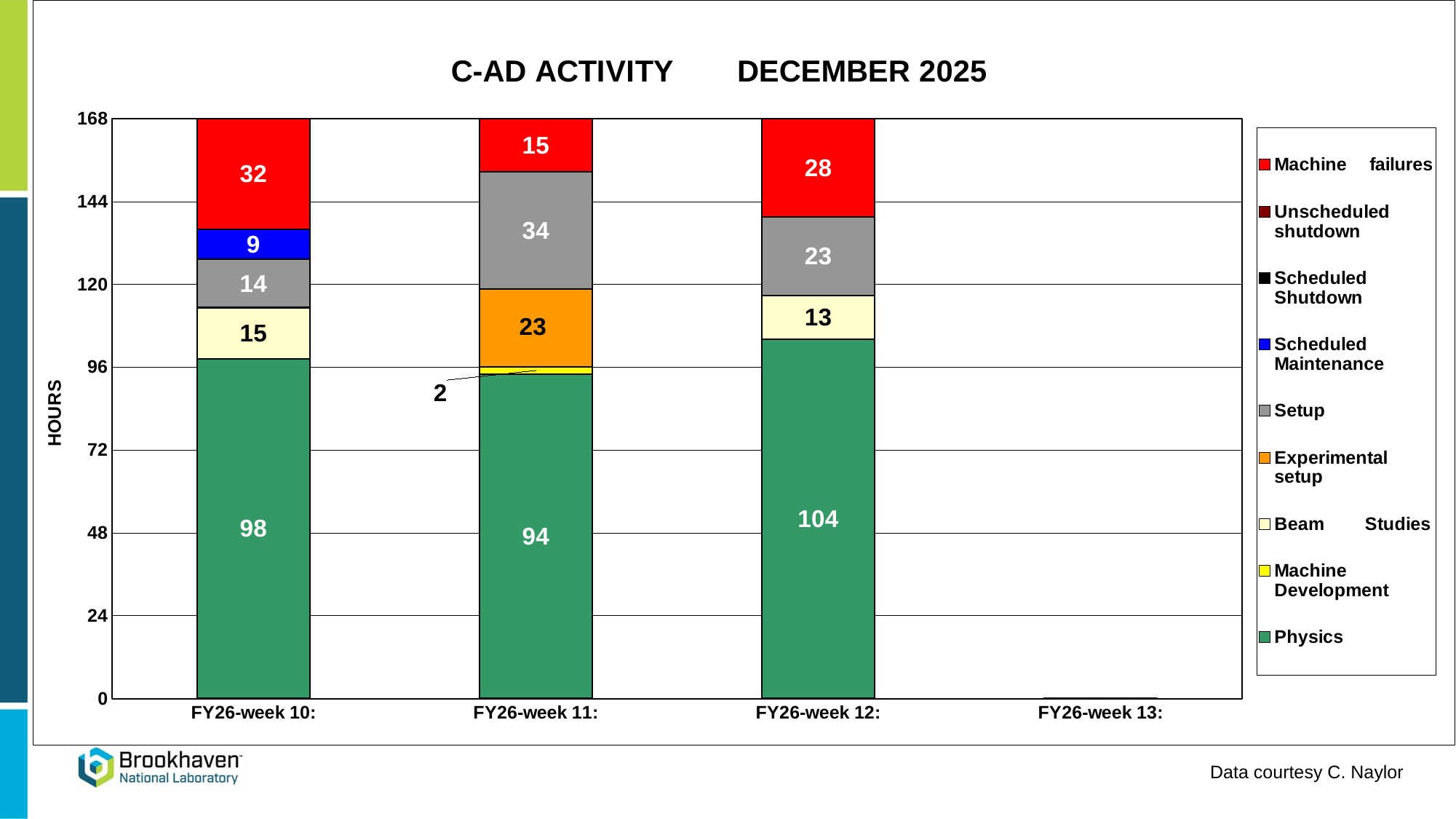
What is the difference in Setup hours between FY26-week 11 and FY26-week 10? 20 What is the title of the chart? C-AD ACTIVITY DECEMBER 2025 Which week has the highest number of Physics hours? FY26-week 12 What kind of chart is shown on the slide? Stacked bar chart How many hours of Scheduled Maintenance are shown for FY26-week 10? 9 How many series does the legend list? 9 What is the total number of hours in the FY26-week 11 bar? 168 Which is larger: Beam Studies hours in FY26-week 10 or in FY26-week 12? FY26-week 10 How many hours of Machine failures are shown for FY26-week 10? 32 How many hours of Physics are shown for FY26-week 12? 104 Which week has the lowest number of Machine failures hours? FY26-week 11 How many hours of Experimental setup are shown for FY26-week 11? 23